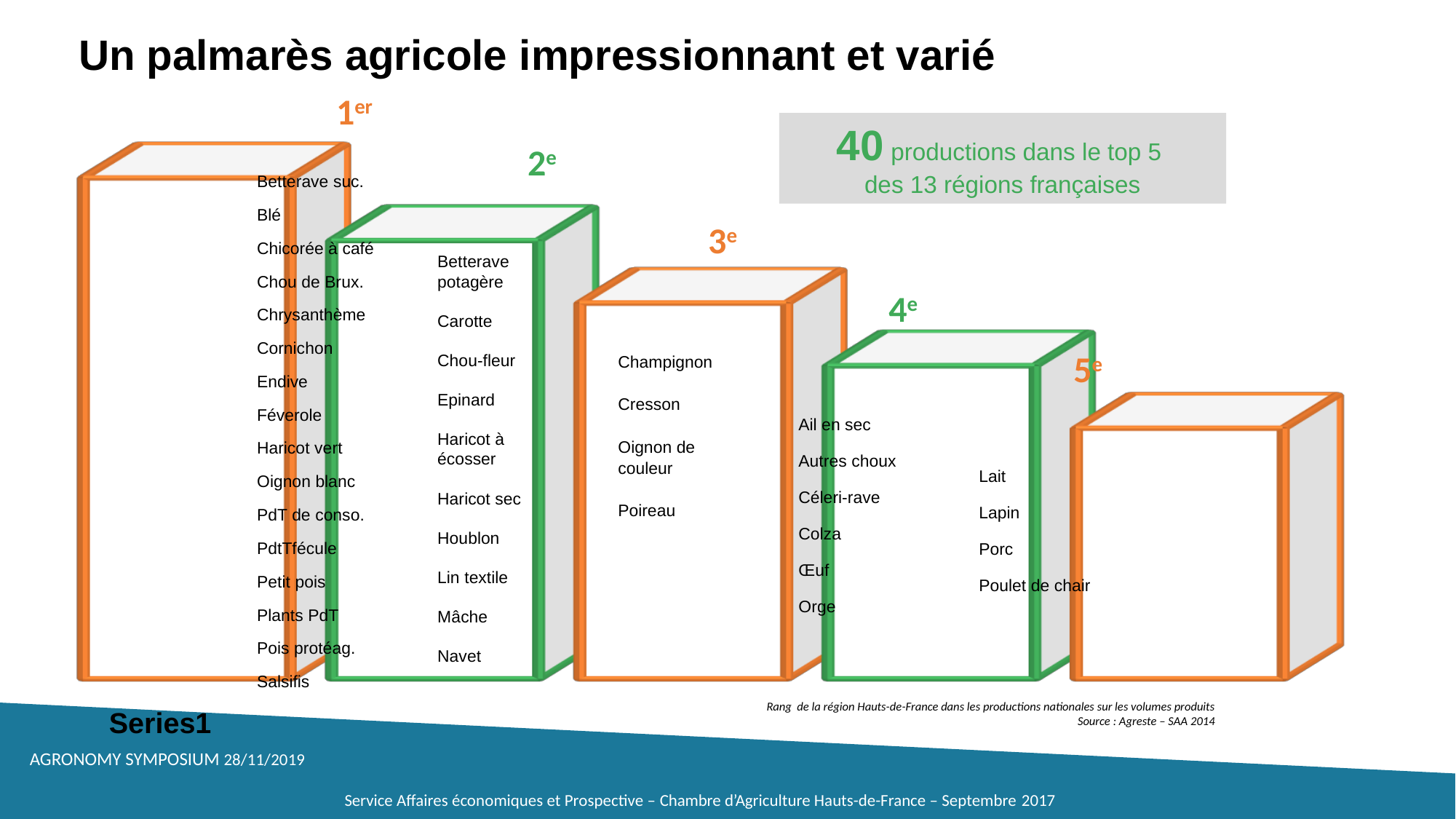
Do the bar heights rise or fall from left to right across the chart? fall How many productions are listed under the bar labelled 4e? 6 What kind of chart is shown on the slide? bar chart How many productions are listed under the bar labelled 3e? 4 Which bar is the shortest in the chart? 5e Which bar is the tallest in the chart? 1er How many productions are listed under the bar labelled 5e? 4 What is the title of the slide containing the chart? Un palmarès agricole impressionnant et varié Which bar is taller, the one labelled 3e or the one labelled 4e? 3e